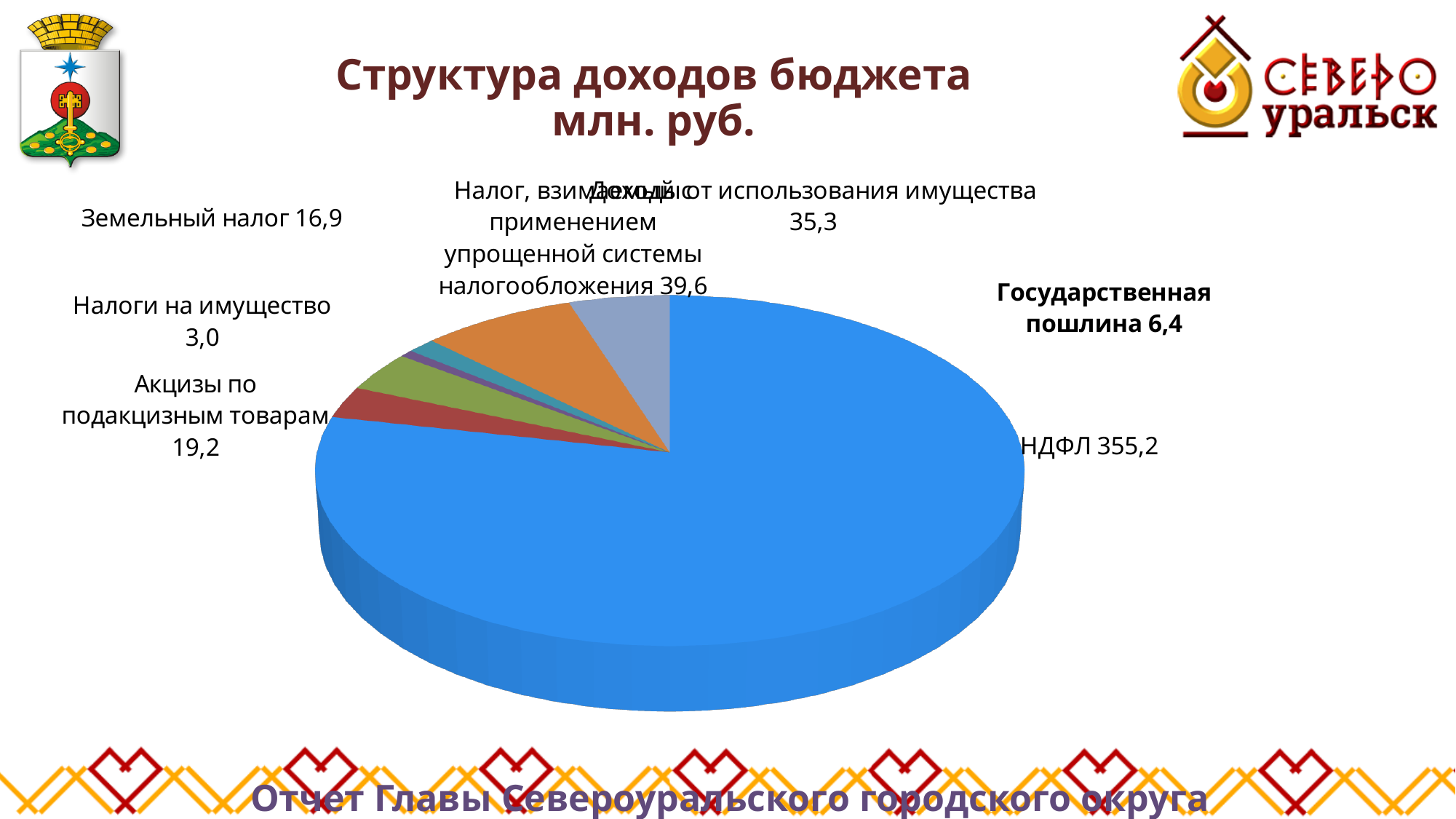
What is the value for Налог, взимаемый с применением упрощенной системы налогообложения? 39,6 What is the value for НДФЛ? 355,2 What is the difference between Акцизы по подакцизным товарам and Земельный налог? 2,3 Which category has the smallest value? Налоги на имущество Which is larger: Государственная пошлина or Налоги на имущество? Государственная пошлина What is the title of the chart? Структура доходов бюджета млн. руб. How many categories does the pie chart show? 7 What is the value for Государственная пошлина? 6,4 What kind of chart is shown on the slide? Pie chart What is the value for Доходы от использования имущества? 35,3 What is the difference between Налог, взимаемый с применением упрощенной системы налогообложения and Доходы от использования имущества? 4,3 Which category has the largest value? НДФЛ